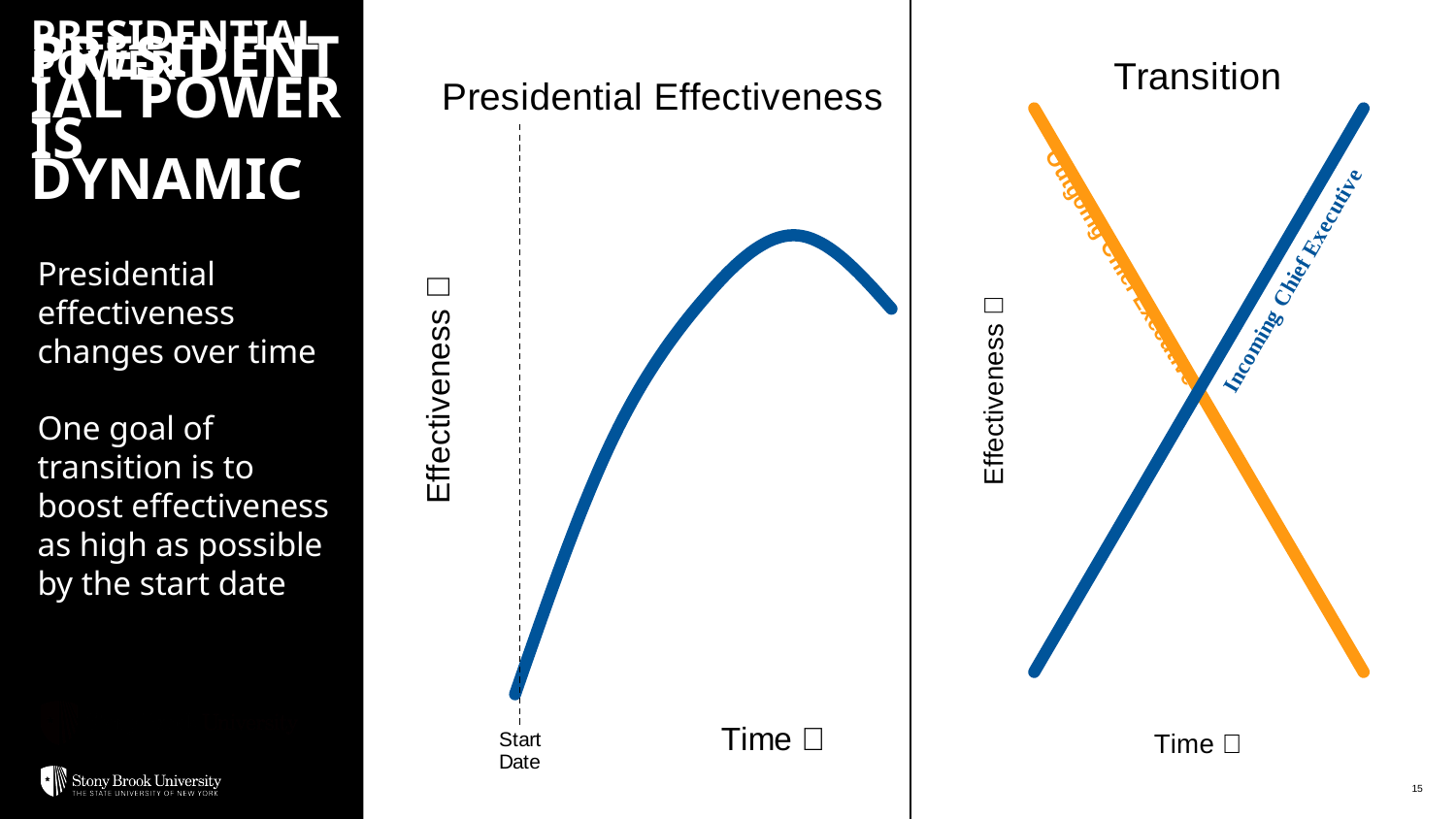
In the "Transition" chart, does the "Incoming Chief Executive" line rise or fall over time? Rises What is the y-axis label of the "Presidential Effectiveness" chart? Effectiveness In the "Transition" chart, which line is higher at the right end of the time axis, Incoming Chief Executive or Outgoing Chief Executive? Incoming Chief Executive In the "Transition" chart, does the "Outgoing Chief Executive" line rise or fall over time? Falls In the "Transition" chart, which line is higher at the left end of the time axis, Incoming Chief Executive or Outgoing Chief Executive? Outgoing Chief Executive How many lines are plotted in the "Transition" chart? 2 In the "Transition" chart, which line is drawn in blue? Incoming Chief Executive In the "Presidential Effectiveness" chart, how does effectiveness change as time moves from the start date to the right? It rises, peaks, then falls In the "Presidential Effectiveness" chart, what label marks the dashed vertical line at the left of the x axis? Start Date What kind of chart is the "Transition" chart? Line chart What kind of chart is the "Presidential Effectiveness" chart? Line chart